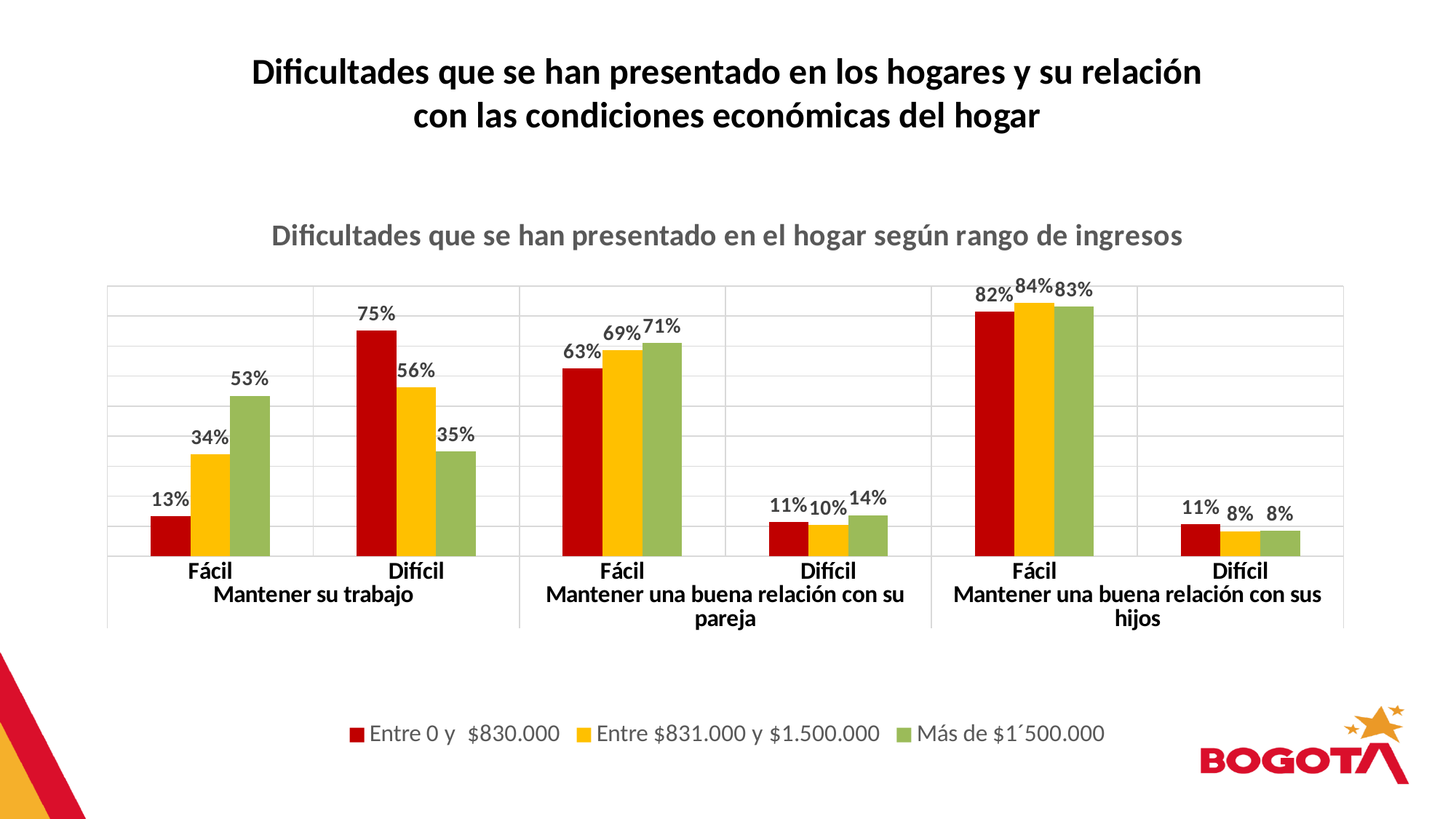
How many series does the legend list? 3 What is the title of the chart? Dificultades que se han presentado en el hogar según rango de ingresos What kind of chart is shown on the slide? Bar chart What is the difference between the 'Más de $1´500.000' and 'Entre 0 y $830.000' values in the 'Fácil' category under 'Mantener su trabajo'? 40% What is the value for 'Entre $831.000 y $1.500.000' in the 'Fácil' category under 'Mantener una buena relación con sus hijos'? 84% What is the value for 'Entre 0 y $830.000' in the 'Fácil' category under 'Mantener su trabajo'? 13% What is the difference between the 'Entre 0 y $830.000' and 'Entre $831.000 y $1.500.000' values in the 'Difícil' category under 'Mantener una buena relación con sus hijos'? 3% Which income range has the highest value in the 'Difícil' category under 'Mantener su trabajo'? Entre 0 y $830.000 What is the value for 'Más de $1´500.000' in the 'Difícil' category under 'Mantener su trabajo'? 35% Which is larger in the 'Fácil' category under 'Mantener una buena relación con su pareja': the value for 'Entre 0 y $830.000' or for 'Más de $1´500.000'? Más de $1´500.000 Which colour represents the 'Más de $1´500.000' series? Green Which income range has the lowest value in the 'Fácil' category under 'Mantener su trabajo'? Entre 0 y $830.000